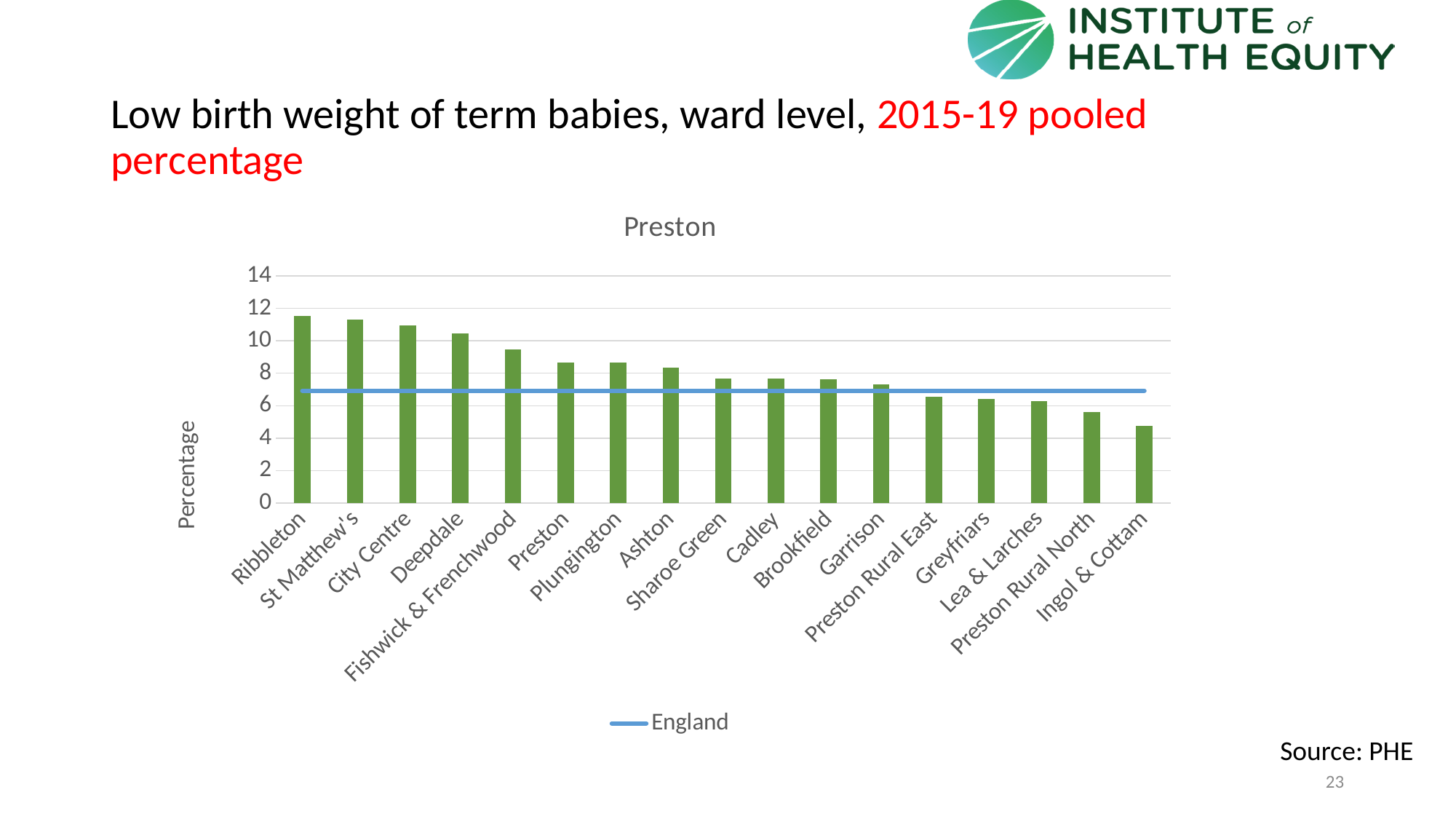
Is the value for Ingol & Cottam greater or less than 6? less How many wards are shown on the x axis? 17 Which ward has the highest low birth weight percentage? Ribbleton Is the value for Ribbleton greater or less than 10? greater What kind of chart is shown on the slide? Bar chart Which ward has the lowest low birth weight percentage? Ingol & Cottam What does the horizontal blue line in the chart represent, according to the legend? England Which is larger, the value for Fishwick & Frenchwood or the value for Preston? Fishwick & Frenchwood Do the bar values rise or fall moving from left to right along the x axis? Fall How many entries does the legend list? 1 Is the value for Fishwick & Frenchwood greater or less than 10? less